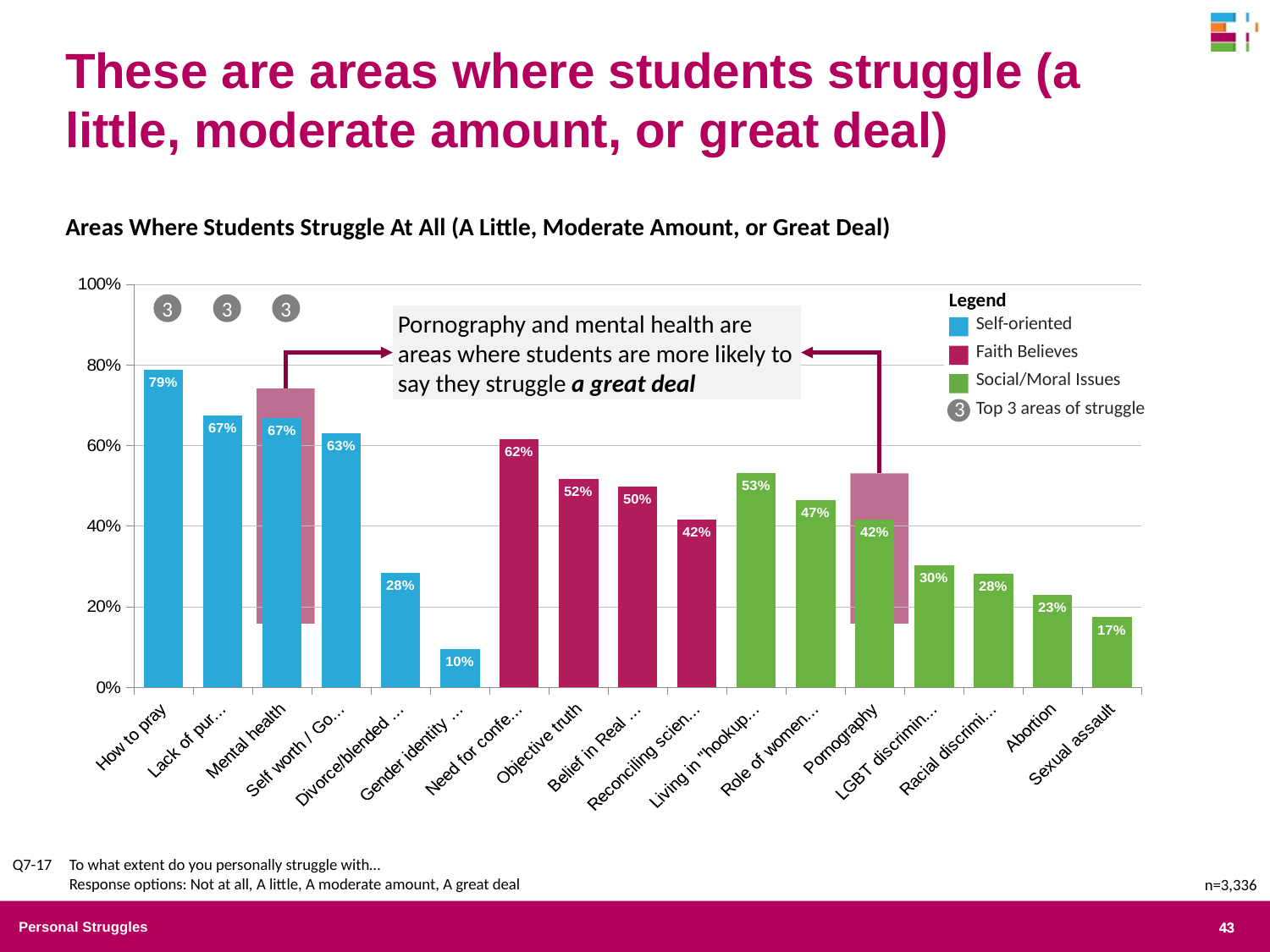
Which is larger, the value for Objective truth or the value for Pornography? Objective truth What colour are the bars in the Social/Moral Issues group? Green What kind of chart is shown on the slide? Bar chart What is the value for Abortion? 23% What is the value for Mental health? 67% What is the difference between the values for How to pray and Mental health? 12% What is the value for Sexual assault? 17% How many bars are shown in the chart? 17 Which category has the lowest value? Gender identity What is the value for How to pray? 79% What is the value for Pornography? 42% Which category has the highest value? How to pray